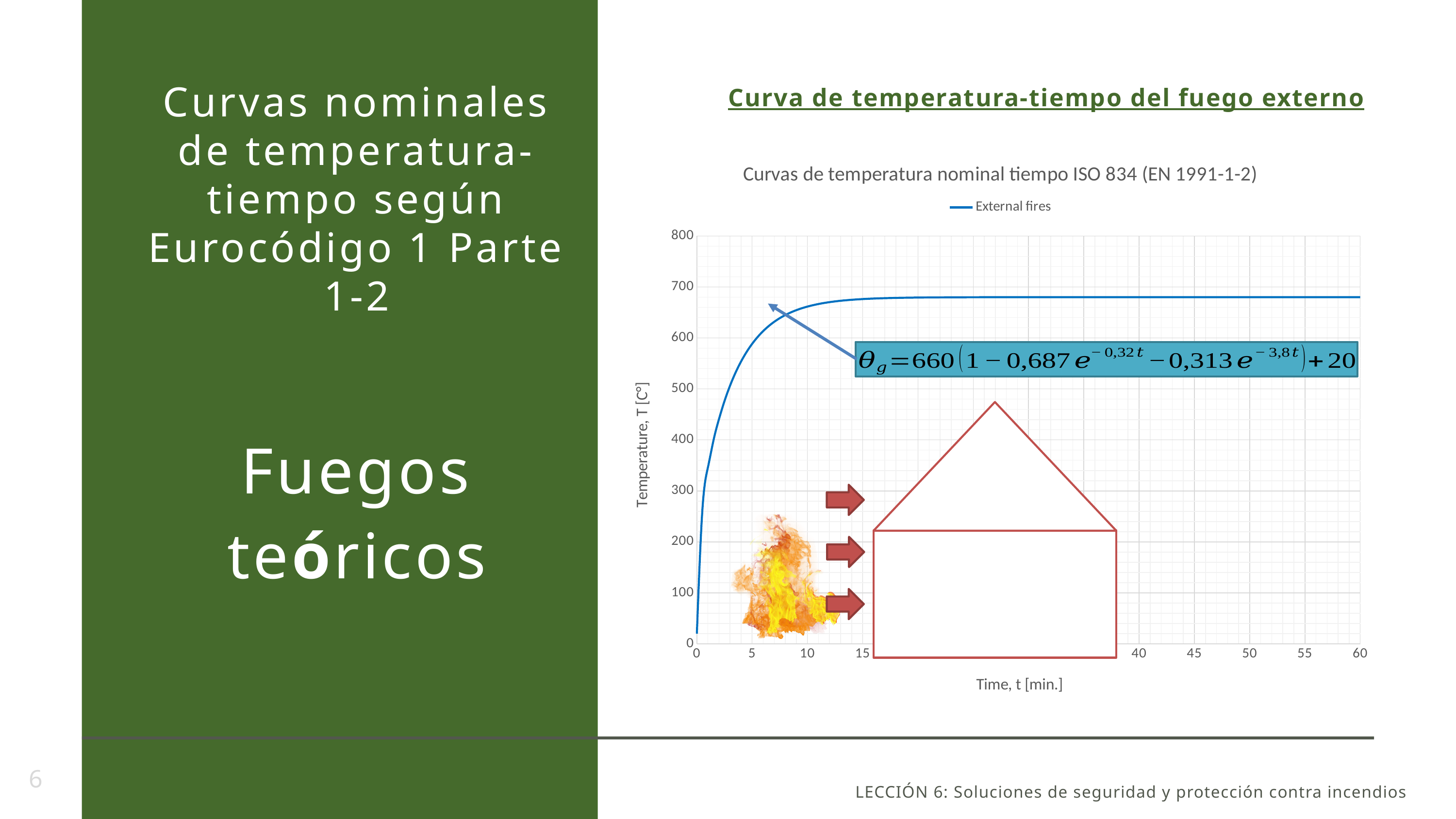
Is the value of the External fires curve at 60 minutes greater or less than 700? less Is the value of the External fires curve at 0 minutes greater or less than 100? less Is the value of the External fires curve at 30 minutes greater or less than 500? greater Does the External fires curve rise or fall as time increases from 0 to 10 minutes? rise What is the title of the chart? Curvas de temperatura nominal tiempo ISO 834 (EN 1991-1-2) How many series does the chart legend list? 1 What is the name of the series shown in the chart legend? External fires What is the highest value shown on the horizontal axis of the chart? 60 What kind of chart is shown on the slide? line chart